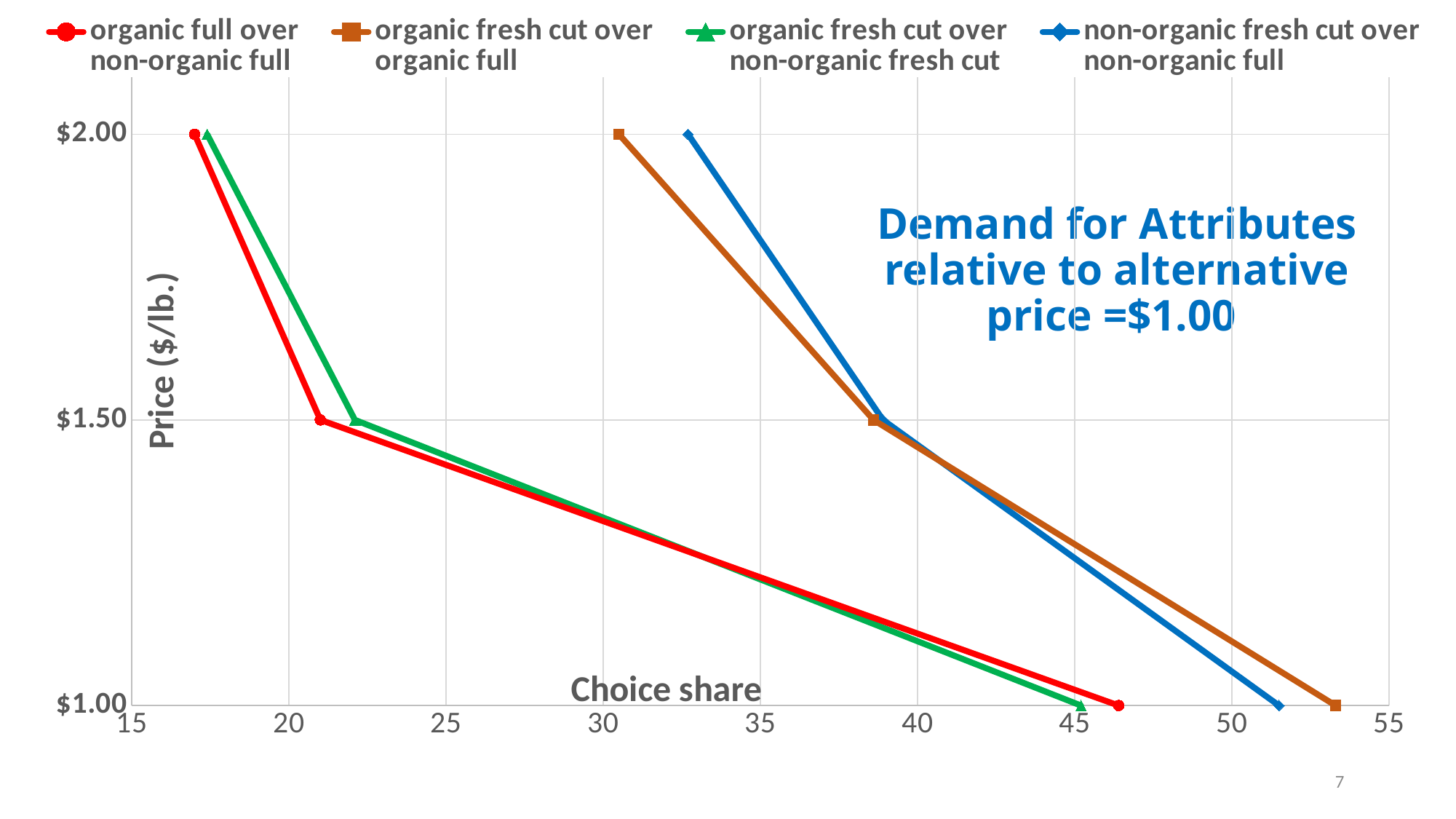
How many series does the legend list? 4 Is the choice share for 'organic fresh cut over organic full' at $1.50 greater or less than 40? less At $1.00, which has the larger choice share: 'organic fresh cut over organic full' or 'non-organic fresh cut over non-organic full'? organic fresh cut over organic full Is the choice share for 'organic fresh cut over organic full' at $1.00 greater or less than 50? greater Is the choice share for 'organic full over non-organic full' at $2.00 greater or less than 20? less At $2.00, which has the larger choice share: 'organic fresh cut over organic full' or 'non-organic fresh cut over non-organic full'? non-organic fresh cut over non-organic full What kind of chart is shown on the slide? line chart What is the label of the vertical axis? Price ($/lb.) As price increases from $1.00 to $2.00, does choice share rise or fall for the series? fall Which series has the highest choice share at $1.00? organic fresh cut over organic full How many price points are plotted for each series? 3